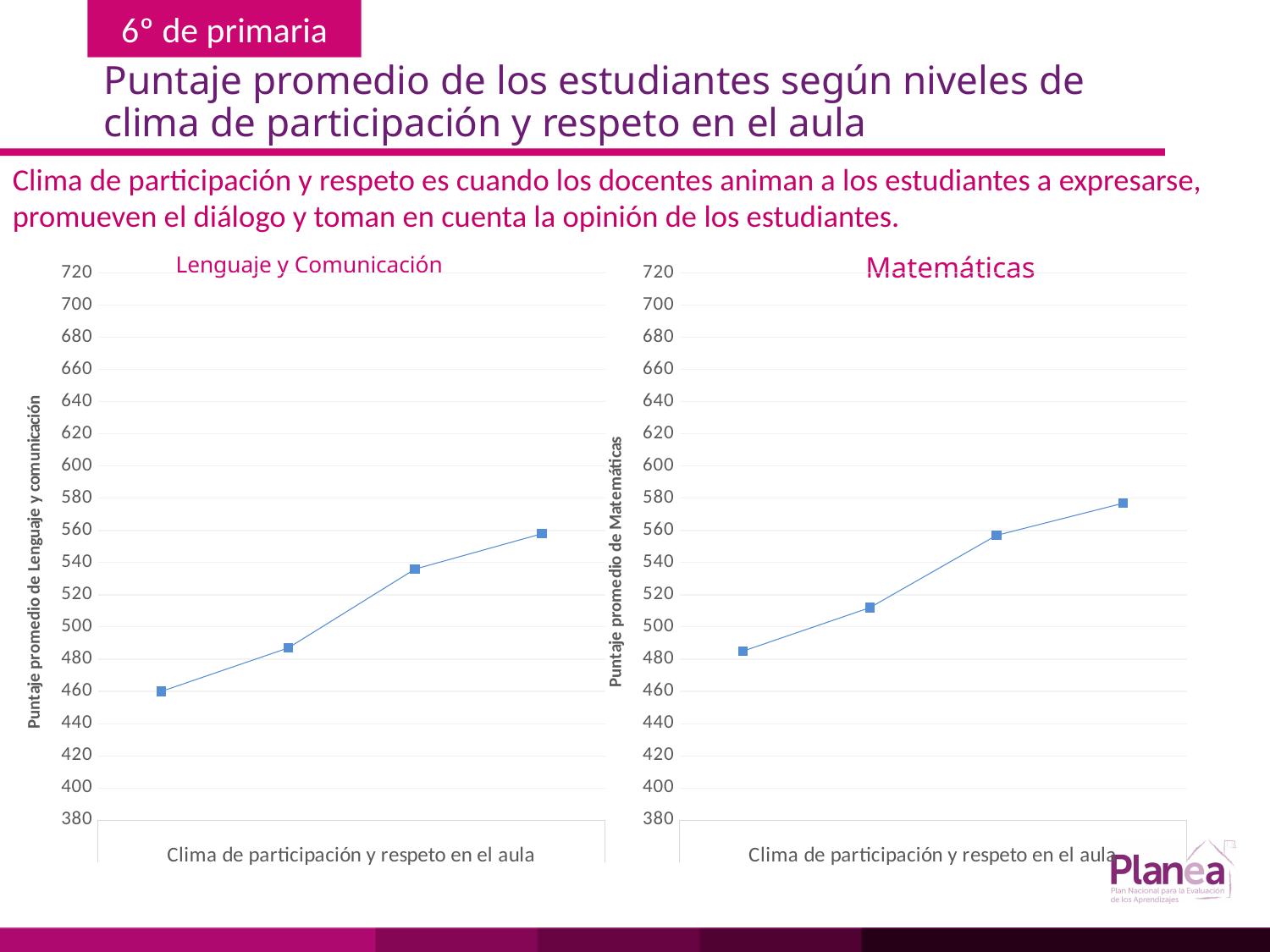
In the Matemáticas chart, do the values rise or fall from left to right along the x axis? rise In the Lenguaje y Comunicación chart, which point has the lowest value: the first, second, third or fourth from the left? first In the Matemáticas chart, which point has the highest value: the first, second, third or fourth from the left? fourth In the Lenguaje y Comunicación chart, is the value of the last (rightmost) point greater or less than 540? greater In the Lenguaje y Comunicación chart, do the values rise or fall from left to right along the x axis? rise Which is larger: the rightmost point in the Matemáticas chart or the rightmost point in the Lenguaje y Comunicación chart? Matemáticas How many data points are plotted in the Matemáticas chart on the right? 4 What kind of chart is the Lenguaje y Comunicación chart on the left? line chart In the Matemáticas chart, is the value of the first (leftmost) point greater or less than 500? less In the Lenguaje y Comunicación chart, is the value of the first (leftmost) point greater or less than 480? less What is the y-axis title of the Matemáticas chart on the right? Puntaje promedio de Matemáticas